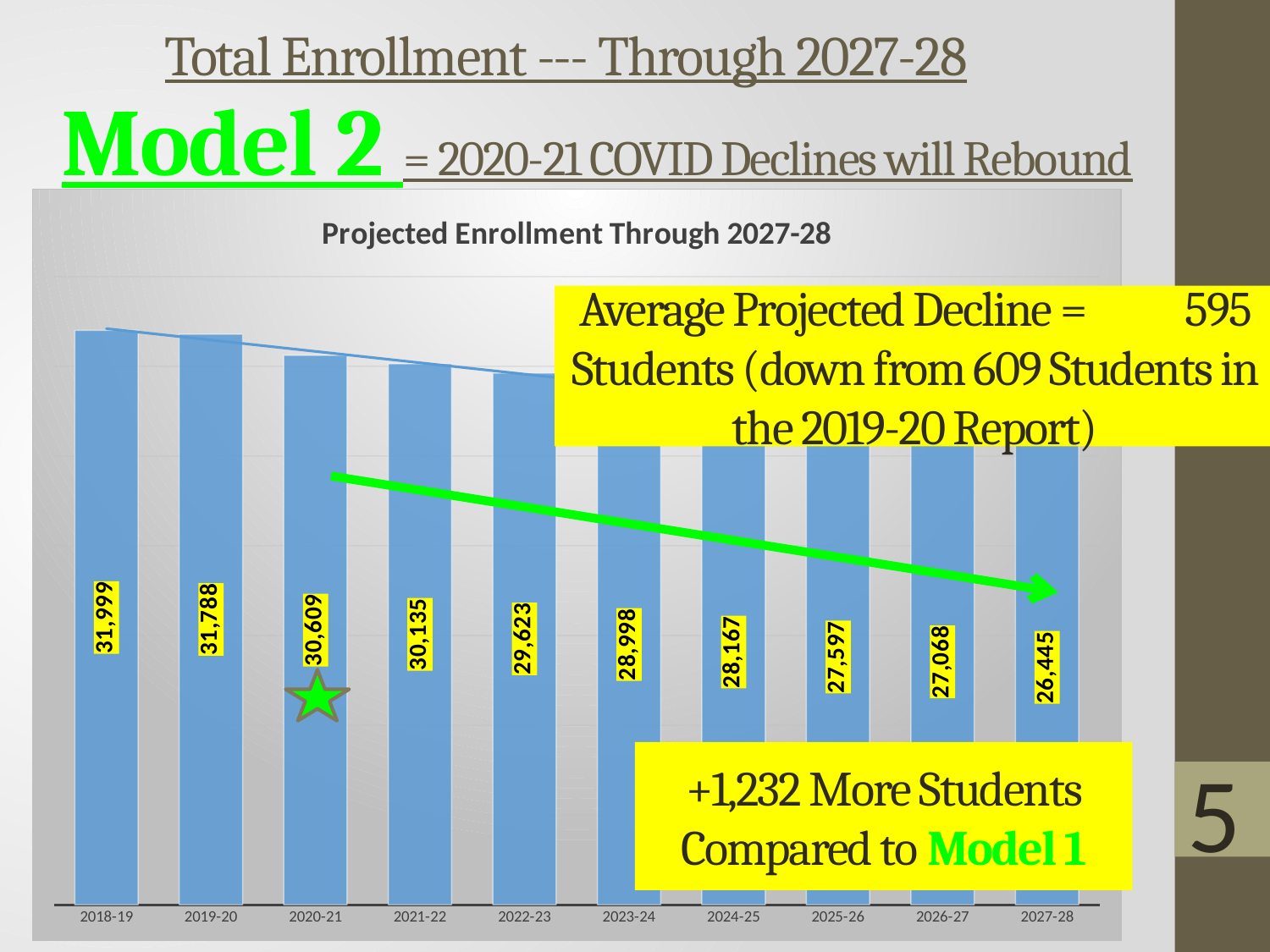
Which year has the highest enrollment in the chart? 2018-19 What type of chart is used to show projected enrollment? Bar chart What is the enrollment value shown for 2020-21? 30,609 What is the difference in enrollment between 2019-20 and 2020-21? 1,179 What is the difference in enrollment between 2018-19 and 2027-28? 5,554 How many years are shown on the x axis of the chart? 10 What is the enrollment value shown for 2018-19? 31,999 Which year has the lowest enrollment in the chart? 2027-28 What is the projected enrollment for 2027-28? 26,445 Which year has a larger enrollment, 2021-22 or 2023-24? 2021-22 What is the enrollment value shown for 2024-25? 28,167 Do the enrollment values rise or fall from 2018-19 to 2027-28? Fall